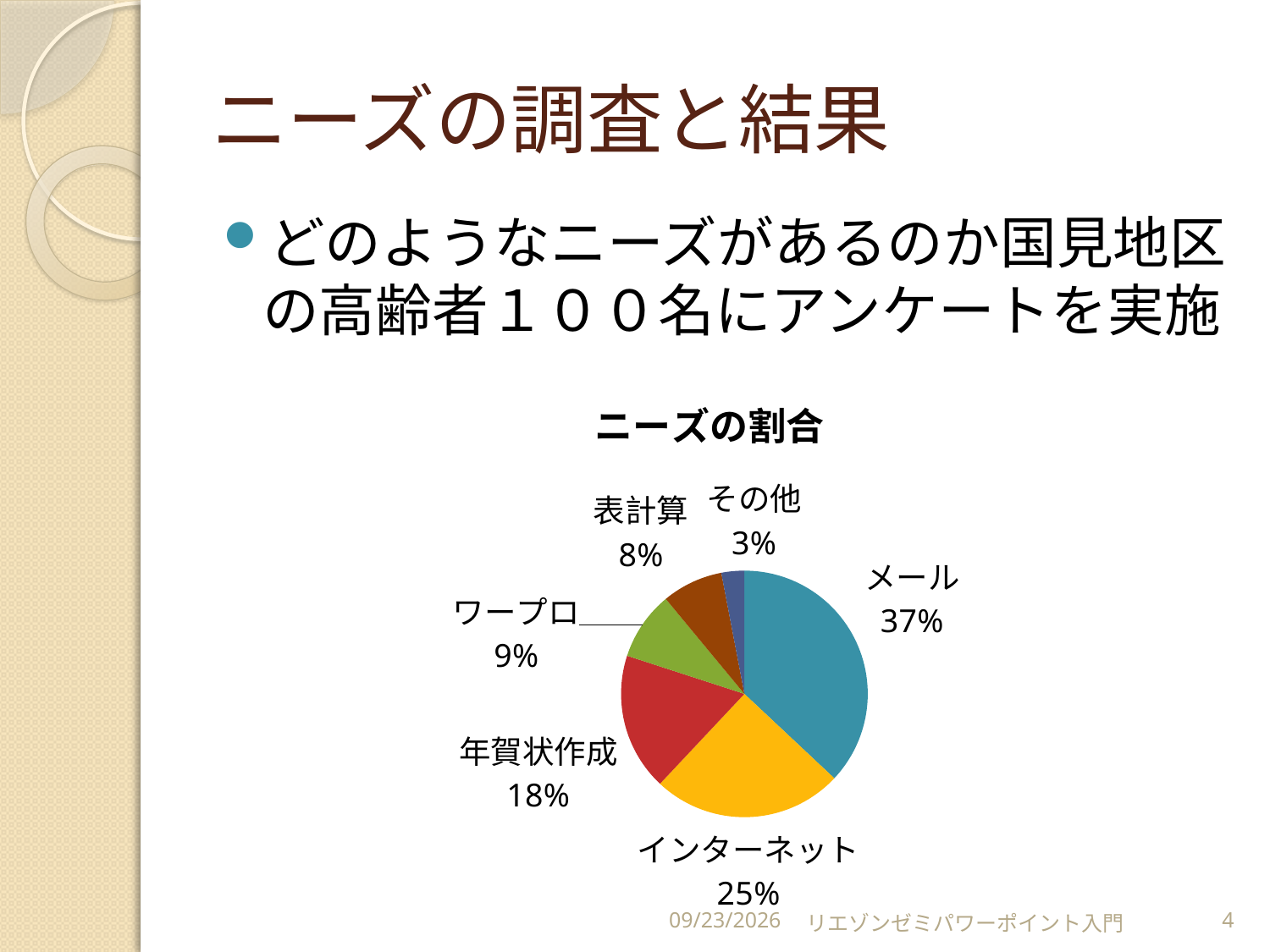
What share of the pie does メール have? 37% What is the value shown for その他? 3% Which category has the largest share of the pie? メール What is the title of the chart? ニーズの割合 What is the difference between the shares of メール and インターネット? 12% Which category has the smallest share of the pie? その他 Which is larger, the share for 表計算 or the share for ワープロ? ワープロ What is the value shown for ワープロ? 9% What is the value shown for インターネット? 25% What is the value shown for 年賀状作成? 18% What type of chart is shown on the slide? pie chart How many categories are shown in the pie chart? 6